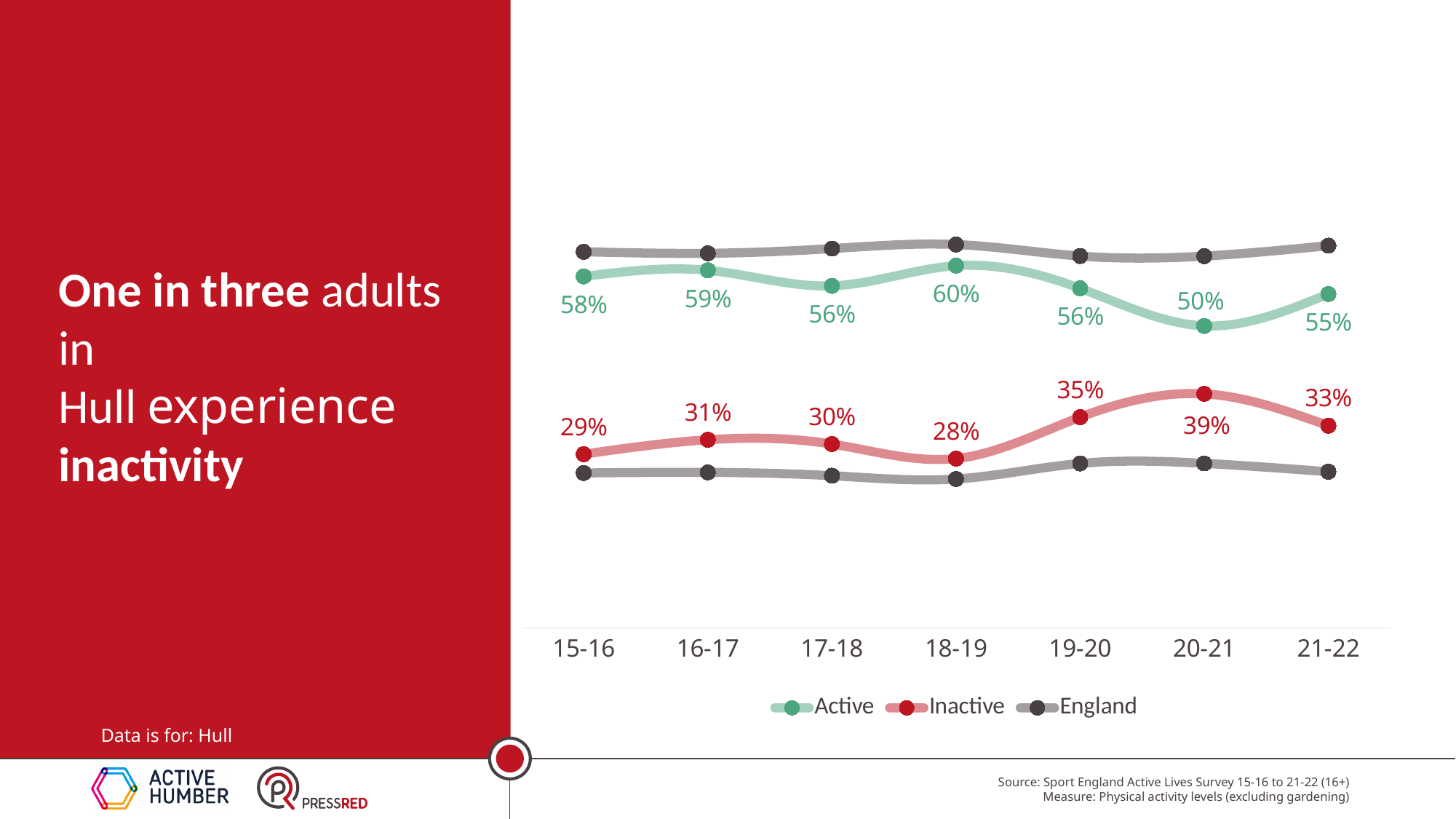
What is the Inactive value for 20-21? 39% In which year is the Inactive value lowest? 18-19 Which is larger, the Inactive value for 19-20 or for 21-22? 19-20 What kind of chart is shown on the slide? Line chart How many series does the legend list? 3 What is the Inactive value for 15-16? 29% In which year is the Inactive value highest? 20-21 What is the Active value for 21-22? 55% What is the difference between the Active values for 18-19 and 20-21? 10% What is the Active value for 18-19? 60% In which year is the Active value lowest? 20-21 How many years are shown on the x axis? 7